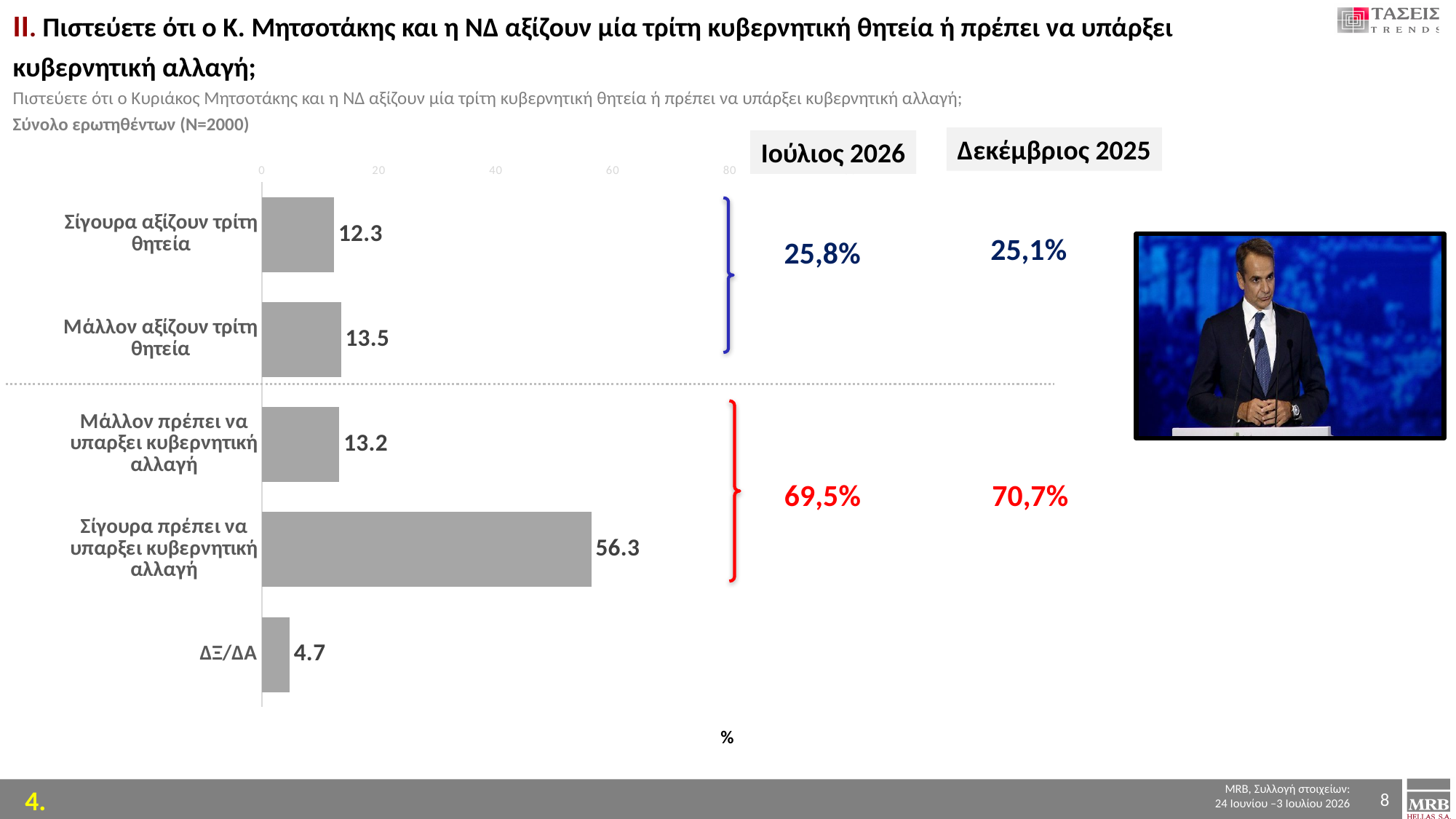
How many categories are plotted in the bar chart? 5 What value is shown for "ΔΞ/ΔΑ"? 4.7 What is the combined percentage shown for Ιούλιος 2026 for the two "αξίζουν τρίτη θητεία" categories? 25,8% What is the difference between the values for "Σίγουρα πρέπει να υπάρξει κυβερνητική αλλαγή" and "Μάλλον πρέπει να υπάρξει κυβερνητική αλλαγή"? 43.1 What value is shown for "Σίγουρα πρέπει να υπάρξει κυβερνητική αλλαγή"? 56.3 What kind of chart is shown on the slide? Bar chart Which category has the lowest value? ΔΞ/ΔΑ What is the combined percentage shown for Δεκέμβριος 2025 for the two "πρέπει να υπάρξει κυβερνητική αλλαγή" categories? 70,7% Which category has the highest value? Σίγουρα πρέπει να υπάρξει κυβερνητική αλλαγή Which is larger: the value for "Μάλλον αξίζουν τρίτη θητεία" or for "Σίγουρα αξίζουν τρίτη θητεία"? Μάλλον αξίζουν τρίτη θητεία What value is shown for "Σίγουρα αξίζουν τρίτη θητεία"? 12.3 What value is shown for "Μάλλον αξίζουν τρίτη θητεία"? 13.5